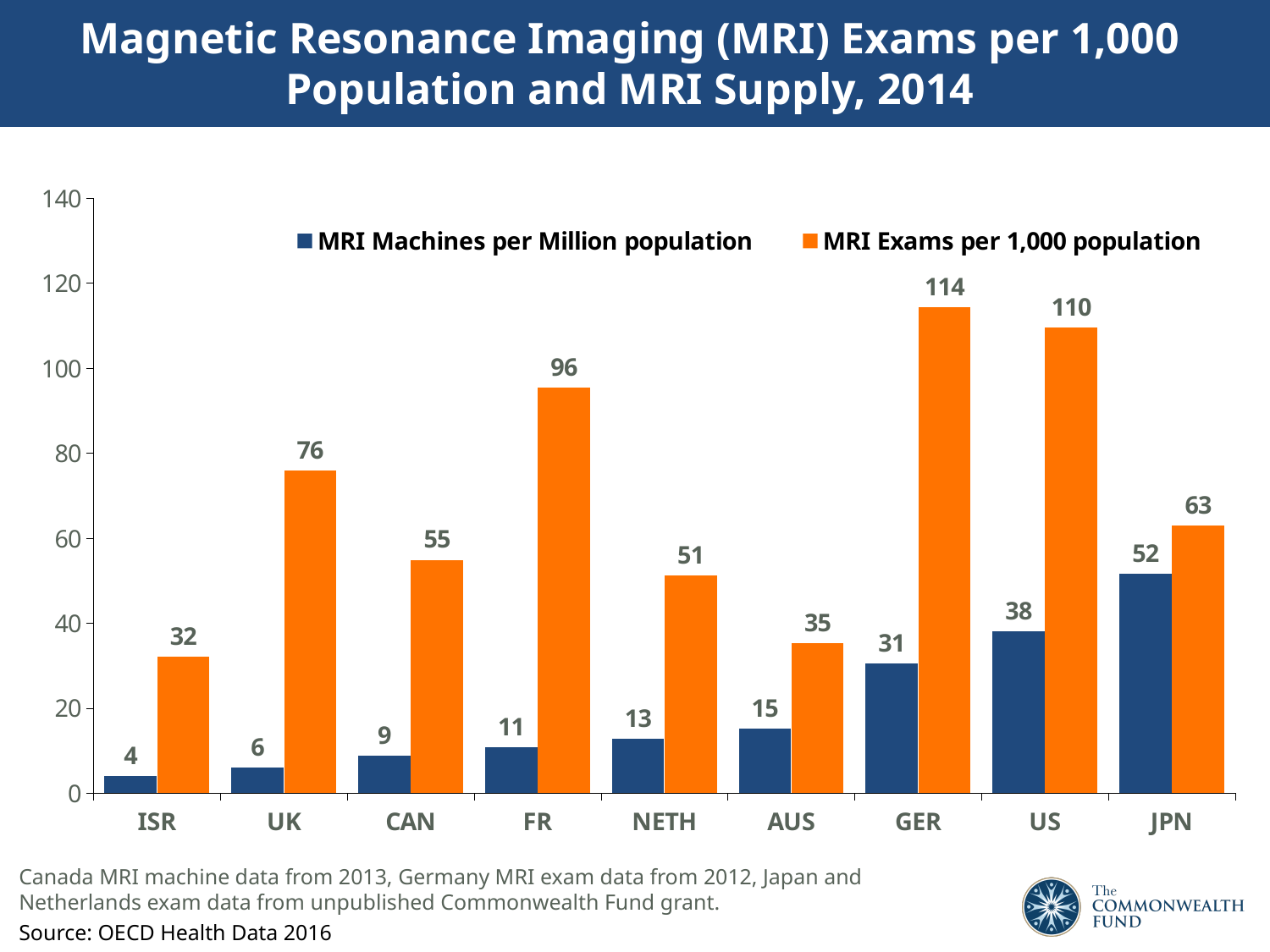
What is the difference between MRI Exams per 1,000 population for the US and for the UK? 34 How many countries are shown on the x axis? 9 What is the value of MRI Exams per 1,000 population for GER? 114 Which country has the lowest value for MRI Machines per Million population? ISR What is the value of MRI Exams per 1,000 population for FR? 96 Which is larger: MRI Exams per 1,000 population for CAN or for NETH? CAN What is the value of MRI Machines per Million population for JPN? 52 Which series is shown in orange? MRI Exams per 1,000 population Is the value of MRI Exams per 1,000 population for JPN greater or less than 60? greater How many series does the legend list? 2 Which country has the highest value for MRI Exams per 1,000 population? GER What kind of chart is shown on the slide? Bar chart